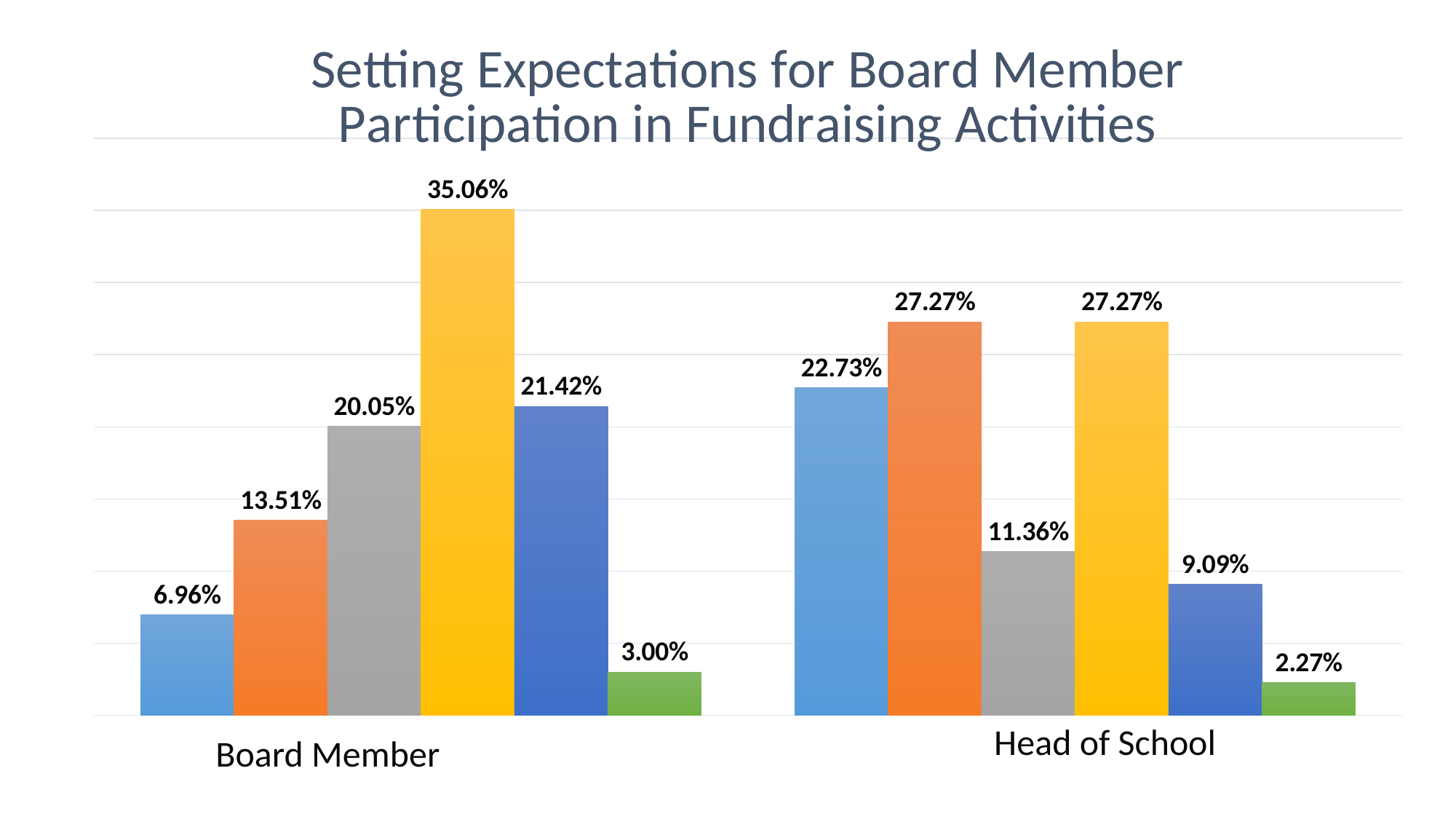
What is the value of the grey bar for Head of School? 11.36% What is the value of the green bar for Board Member? 3.00% What kind of chart is shown on the slide? Bar chart Which is larger: the orange bar for Board Member or the orange bar for Head of School? Head of School (27.27%) What is the difference between the yellow bar for Board Member and the yellow bar for Head of School? 7.79% What is the value of the light blue bar for Head of School? 22.73% What is the value of the yellow bar for Board Member? 35.06% What is the title of the chart? Setting Expectations for Board Member Participation in Fundraising Activities How many categories are shown on the x axis? 2 Which bar in the Head of School group has the lowest value? The green bar (2.27%) How many bars are shown in each category group? 6 Which bar in the Board Member group has the highest value? The yellow bar (35.06%)